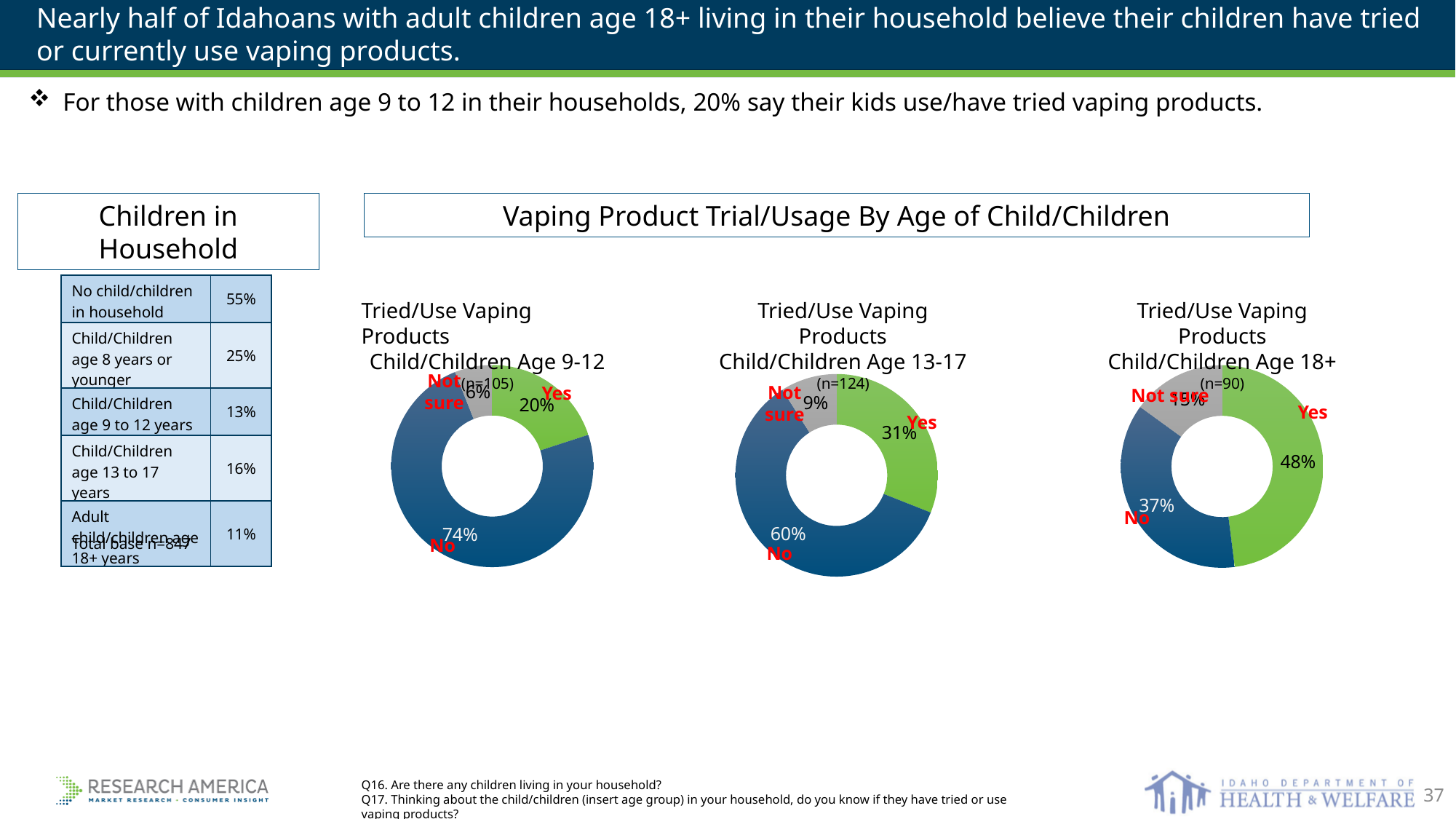
In the Tried/Use Vaping Products Child/Children Age 13-17 chart, what percentage answered No? 60% In the Tried/Use Vaping Products Child/Children Age 13-17 chart, which response has the largest share? No In the Tried/Use Vaping Products Child/Children Age 18+ chart, is the Yes share larger or the No share larger? Yes What type of chart is used for the Tried/Use Vaping Products Child/Children Age 9-12 chart? Donut (pie) chart In the Tried/Use Vaping Products Child/Children Age 9-12 chart, what percentage answered Yes? 20% In the Tried/Use Vaping Products Child/Children Age 9-12 chart, which response has the smallest share? Not sure In the Tried/Use Vaping Products Child/Children Age 13-17 chart, what percentage answered Yes? 31% In the Tried/Use Vaping Products Child/Children Age 9-12 chart, what percentage answered Not sure? 6% In the Tried/Use Vaping Products Child/Children Age 18+ chart, what percentage answered Yes? 48% In the Tried/Use Vaping Products Child/Children Age 13-17 chart, what is the difference between the No and Yes percentages? 29% In the Tried/Use Vaping Products Child/Children Age 9-12 chart, what percentage answered No? 74% In the Tried/Use Vaping Products Child/Children Age 18+ chart, what percentage answered No? 37%